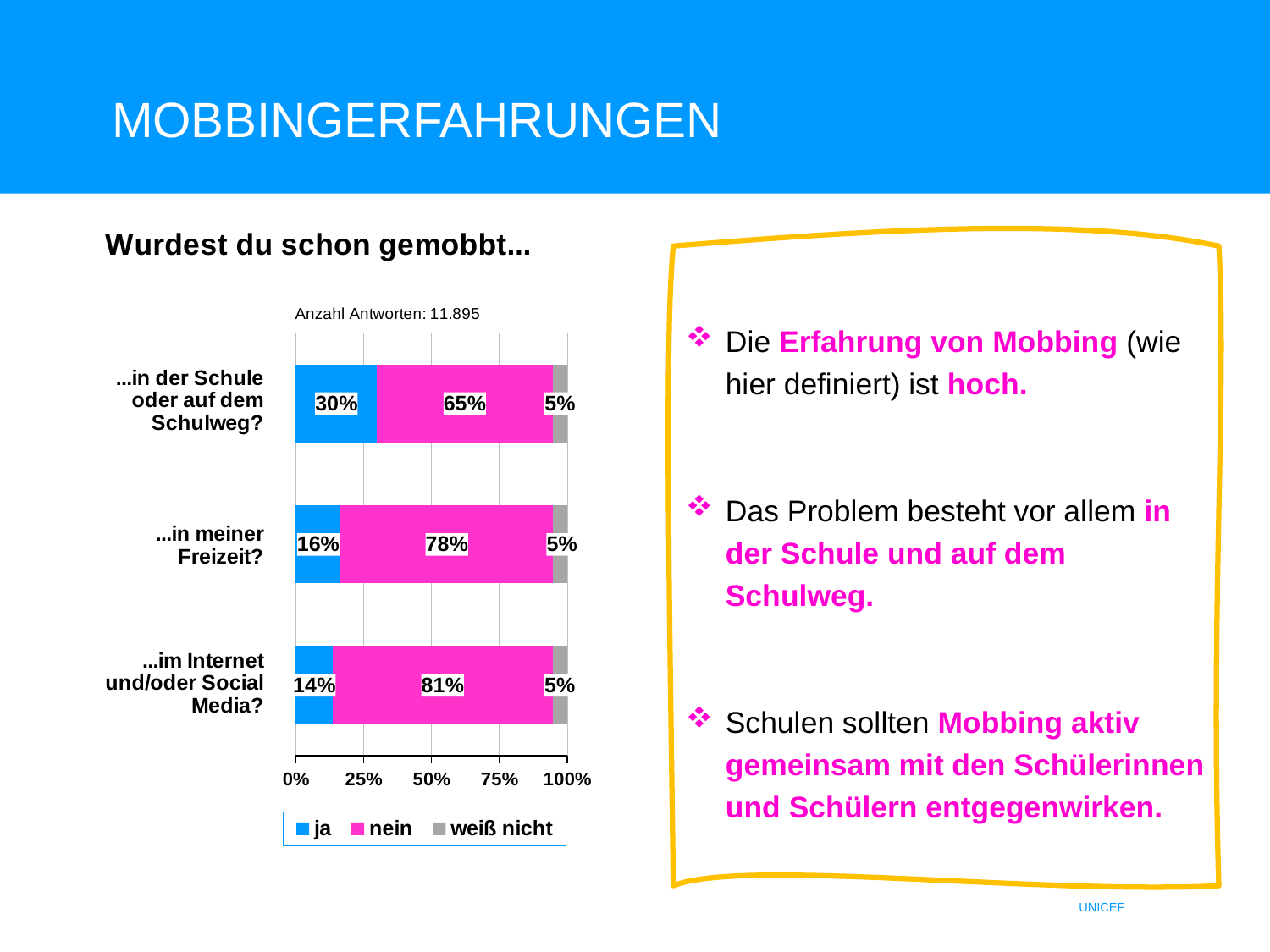
How many series does the legend list? 3 Which category has the highest "ja" share? ...in der Schule oder auf dem Schulweg? Is the "ja" share larger for "...in meiner Freizeit?" or for "...im Internet und/oder Social Media?"? ...in meiner Freizeit? What kind of chart is shown on the slide? Stacked bar chart What percentage answered "ja" for "...in der Schule oder auf dem Schulweg?"? 30% What is the difference between the "nein" share for "...im Internet und/oder Social Media?" and for "...in der Schule oder auf dem Schulweg?"? 16% How many categories are shown in the chart? 3 What percentage answered "ja" for "...im Internet und/oder Social Media?"? 14% Which category has the lowest "ja" share? ...im Internet und/oder Social Media? What percentage answered "weiß nicht" for "...in meiner Freizeit?"? 5% What percentage answered "nein" for "...in meiner Freizeit?"? 78% What is the number of responses (Anzahl Antworten) stated above the chart? 11.895